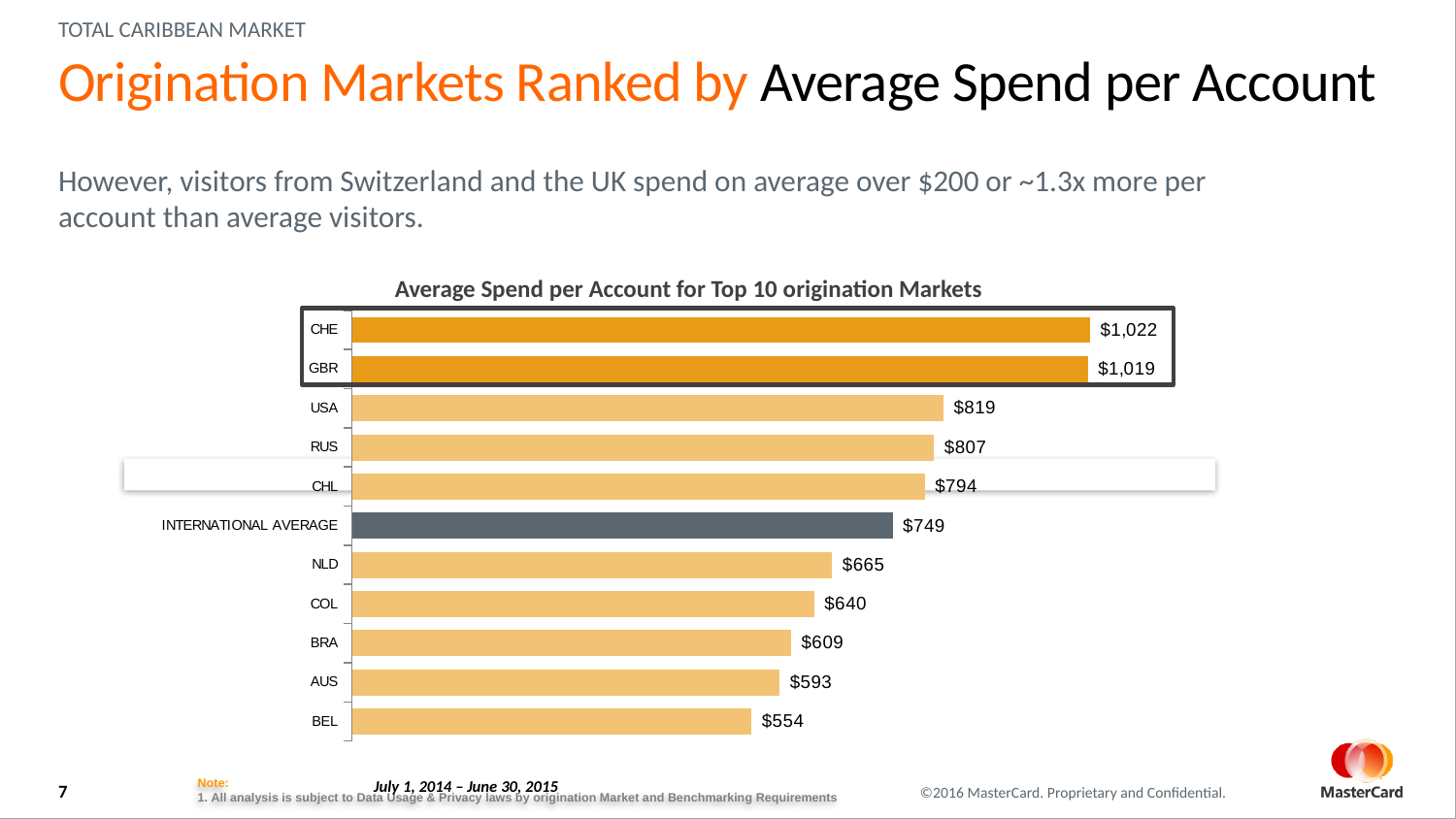
Which origination market has the highest average spend per account? CHE Which has a higher average spend per account, NLD or COL? NLD What kind of chart is shown on the slide? Bar chart How many bars are shown in the chart, including the INTERNATIONAL AVERAGE? 11 What is the difference in average spend per account between CHE and the INTERNATIONAL AVERAGE? $273 What is the average spend per account for the INTERNATIONAL AVERAGE? $749 What is the average spend per account for CHE? $1,022 What is the average spend per account for BEL? $554 Which two bars are highlighted with a box at the top of the chart? CHE and GBR Which origination market has the lowest average spend per account? BEL What is the title of the chart? Average Spend per Account for Top 10 origination Markets What is the difference in average spend per account between USA and RUS? $12